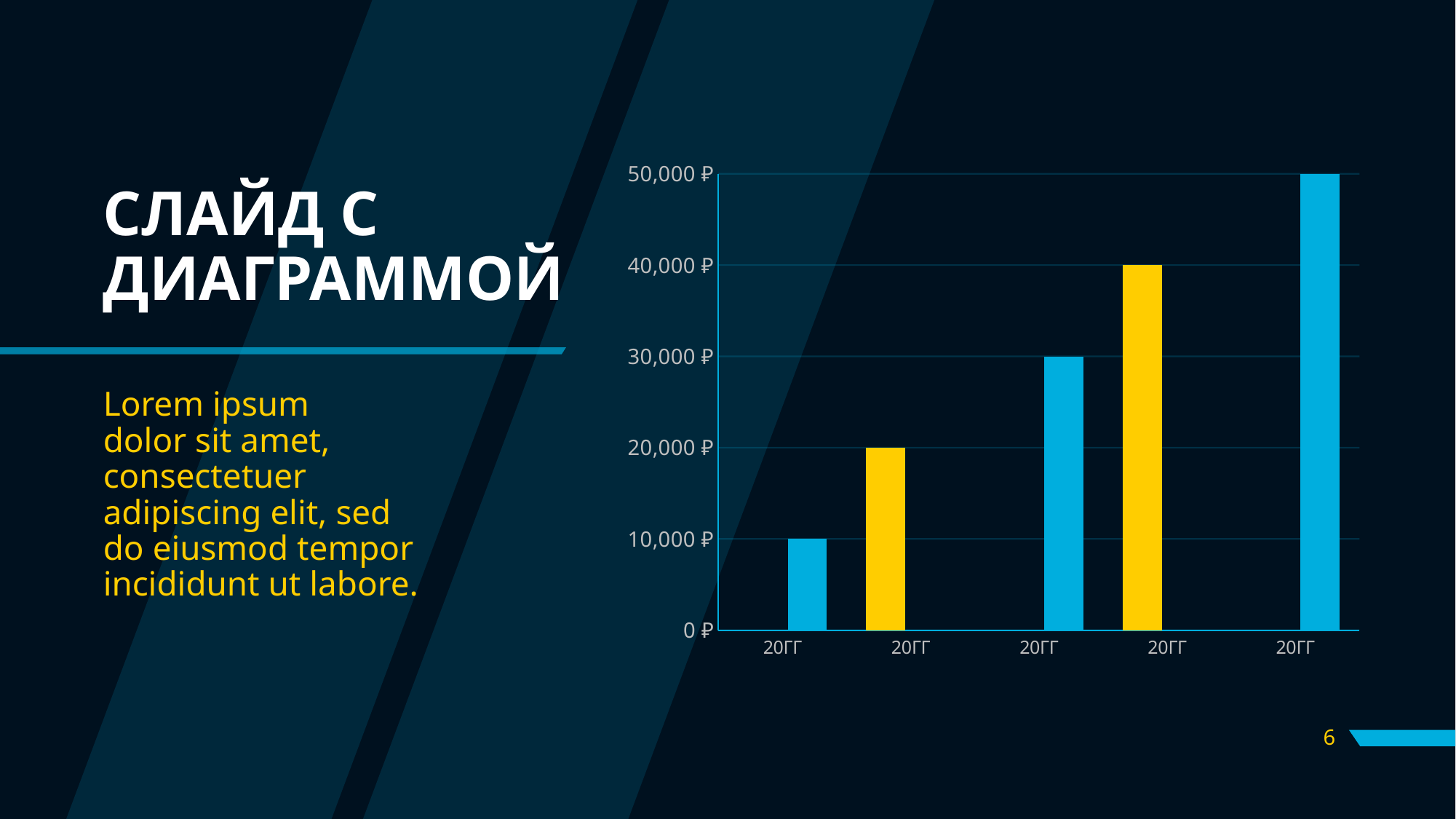
How many bars are plotted in the chart? 5 Do the bar values rise or fall from left to right along the x axis? rise What kind of chart is shown on the slide? bar chart What is the label shown under each bar on the x axis? 20ГГ Which bar has the lowest value in the chart? the first (leftmost) bar What is the difference between the value of the rightmost bar and the leftmost bar? 40,000 ₽ What is the value of the fourth bar from the left in the chart? 40,000 ₽ What is the highest value shown on the vertical axis of the chart? 50,000 ₽ What is the value of the second bar from the left in the chart? 20,000 ₽ What is the value of the first (leftmost) bar in the chart? 10,000 ₽ Which bar has the highest value in the chart? the fifth (rightmost) bar Which is larger, the third bar or the second bar? the third bar